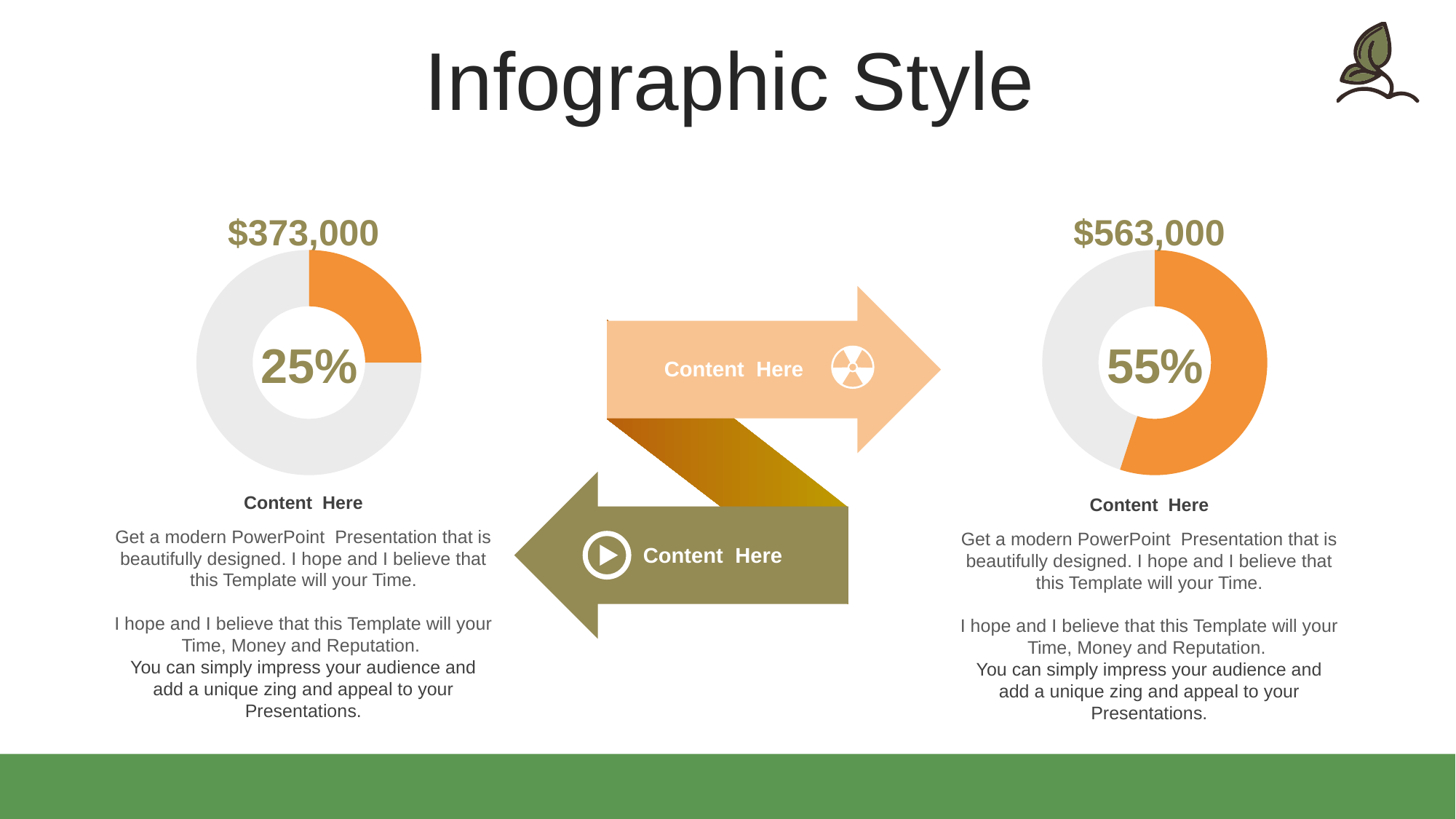
What share of the right donut chart is filled in orange? 55% Which donut chart shows the larger percentage, the left one or the right one? the right one What percentage is shown in the centre of the right donut chart? 55% What kind of chart is used on the left side of the slide? donut chart Which donut chart has the larger dollar value printed above it, the left one or the right one? the right one What dollar value is printed above the right donut chart? $563,000 What percentage is shown in the centre of the left donut chart? 25% What is the difference between the dollar values printed above the right and left donut charts? $190,000 What colour is the filled portion of the right donut chart? orange What dollar value is printed above the left donut chart? $373,000 What is the difference in percentage points between the right donut chart (55%) and the left donut chart (25%)? 30 percentage points What share of the left donut chart is filled in orange? 25%